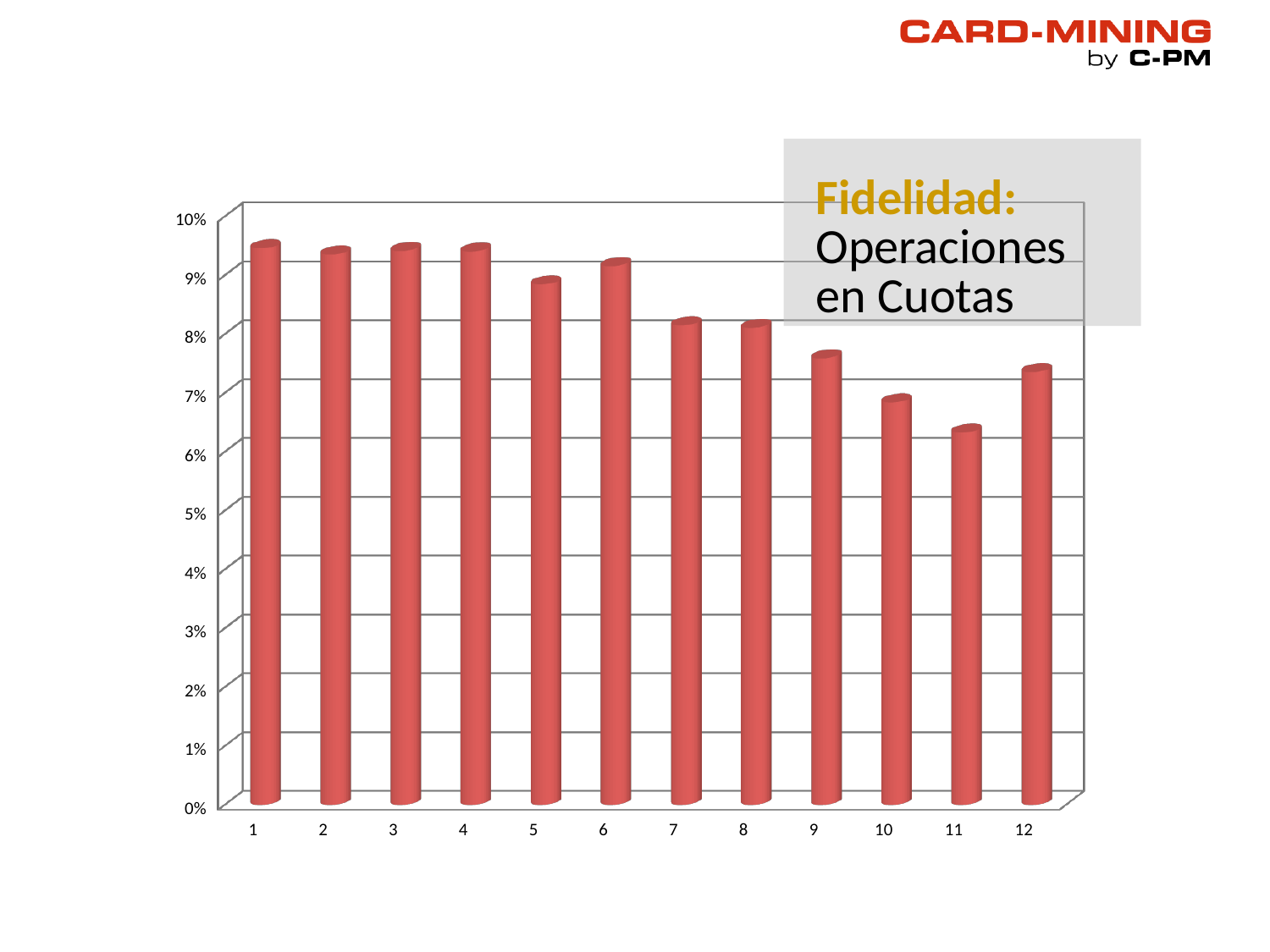
Is the value for category 1 greater or less than 9%? greater Which is larger, the value for category 1 or category 11? Category 1 What kind of chart is shown on the slide? Bar chart Do the values generally rise or fall from category 1 to category 11? Fall Is the value for category 11 greater or less than 6%? greater What is the title shown on the chart? Fidelidad: Operaciones en Cuotas Is the value for category 12 greater or less than 7%? greater Which category has the lowest value? 11 How many categories are plotted along the x axis? 12 Which is larger, the value for category 10 or category 12? Category 12